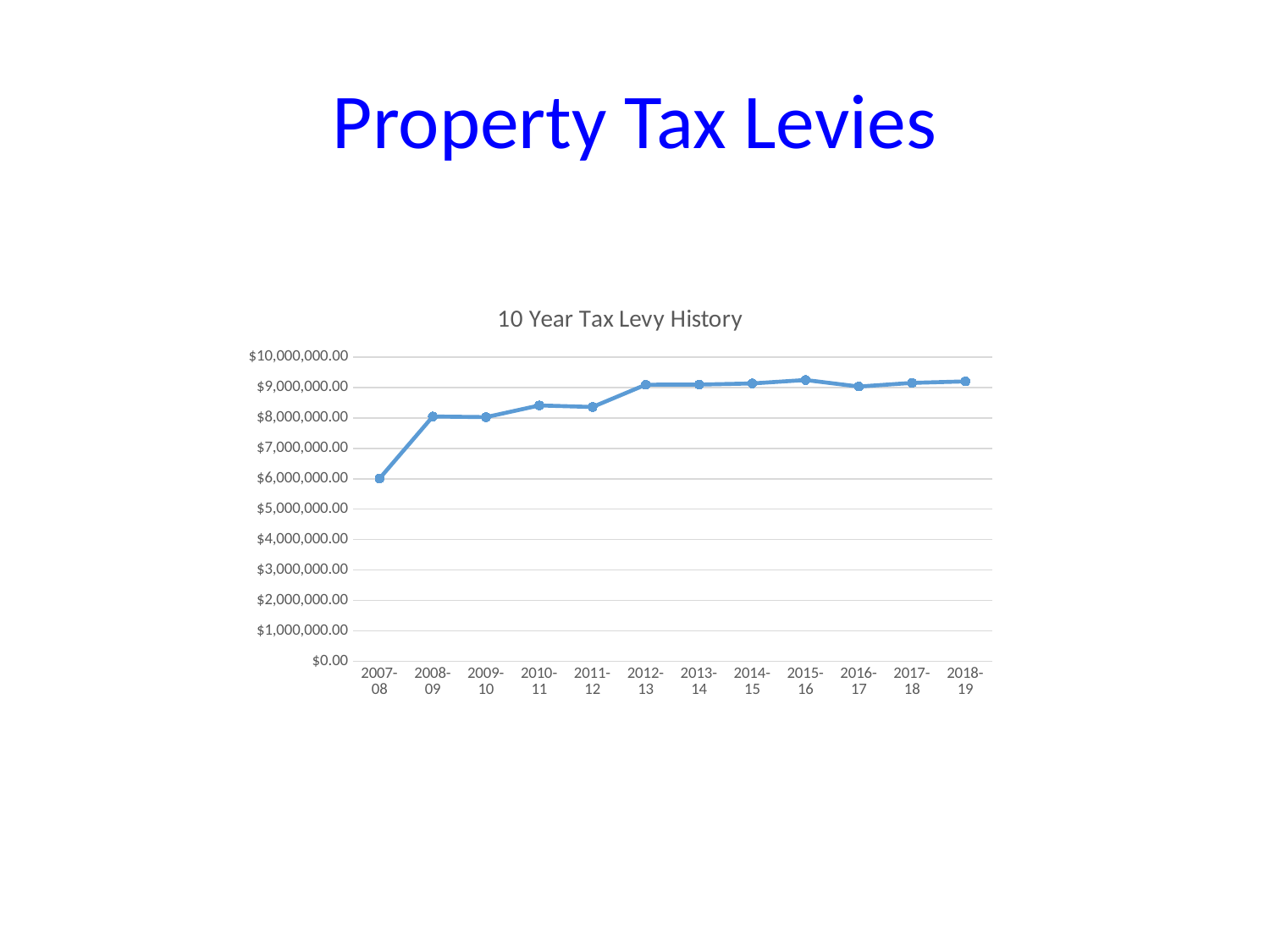
What is the title of the chart? 10 Year Tax Levy History Overall, does the tax levy rise or fall from 2007-08 to 2018-19? rise Which fiscal year has the lowest tax levy? 2007-08 What kind of chart is shown on the slide? line chart Is the value for 2010-11 greater or less than $8,000,000.00? greater Is the value for 2007-08 greater or less than $7,000,000.00? less Is the value for 2016-17 greater or less than $8,000,000.00? greater Which is larger, the tax levy for 2007-08 or for 2010-11? 2010-11 Which is larger, the tax levy for 2008-09 or for 2012-13? 2012-13 How many fiscal years are plotted on the x axis? 12